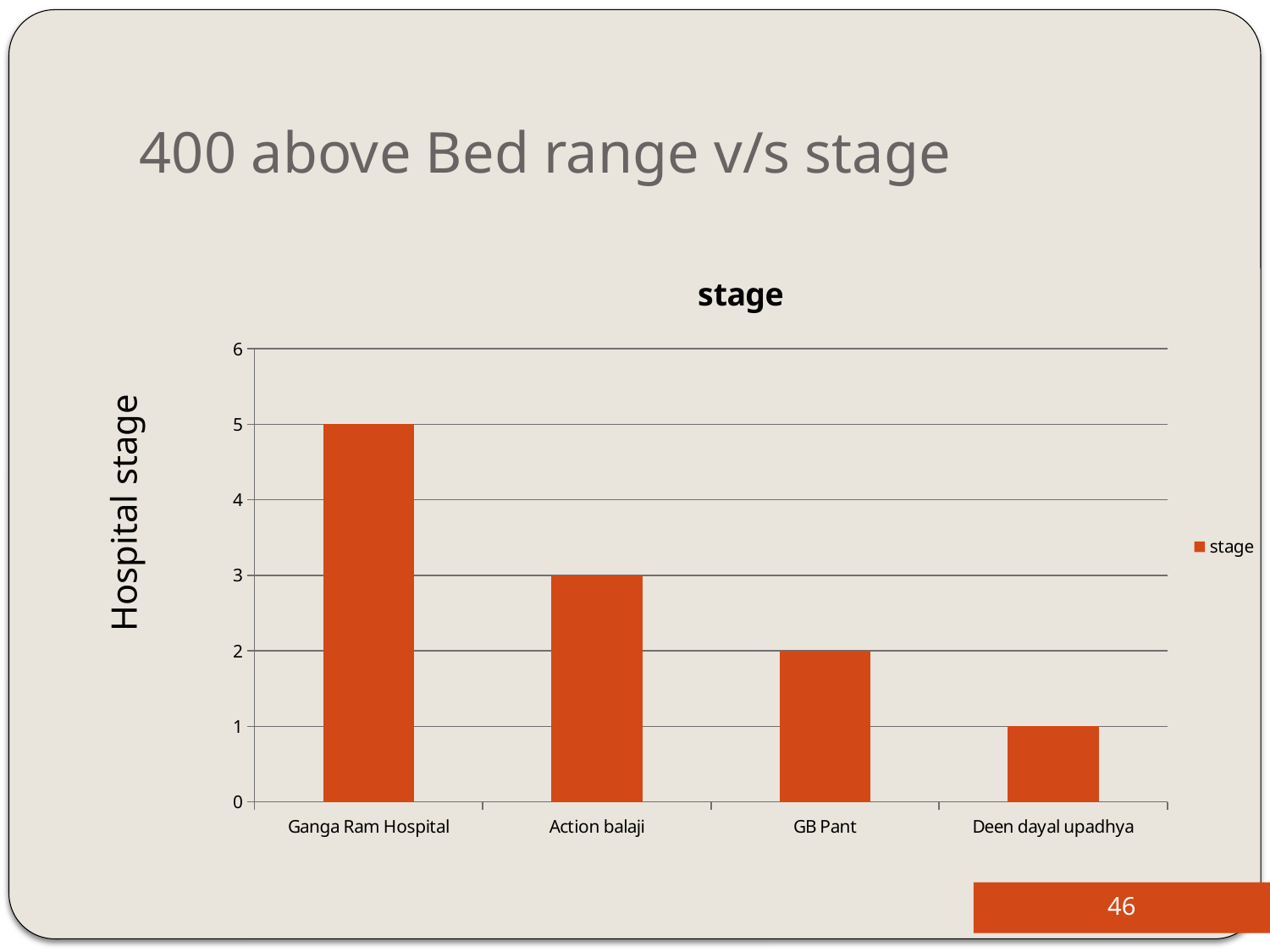
How many hospitals are shown on the x axis of the chart? 4 What is the stage value for Action balaji? 3 Which has a larger stage value, GB Pant or Deen dayal upadhya? GB Pant What is the stage value for GB Pant? 2 Which hospital has the highest stage value? Ganga Ram Hospital Which hospital has the lowest stage value? Deen dayal upadhya What is the stage value for Ganga Ram Hospital? 5 Do the stage values rise or fall from left to right across the hospitals? fall What is the stage value for Deen dayal upadhya? 1 What is the difference between the stage values of Ganga Ram Hospital and Action balaji? 2 Is the stage value for Action balaji greater or less than 4? less What kind of chart is shown on the slide? bar chart